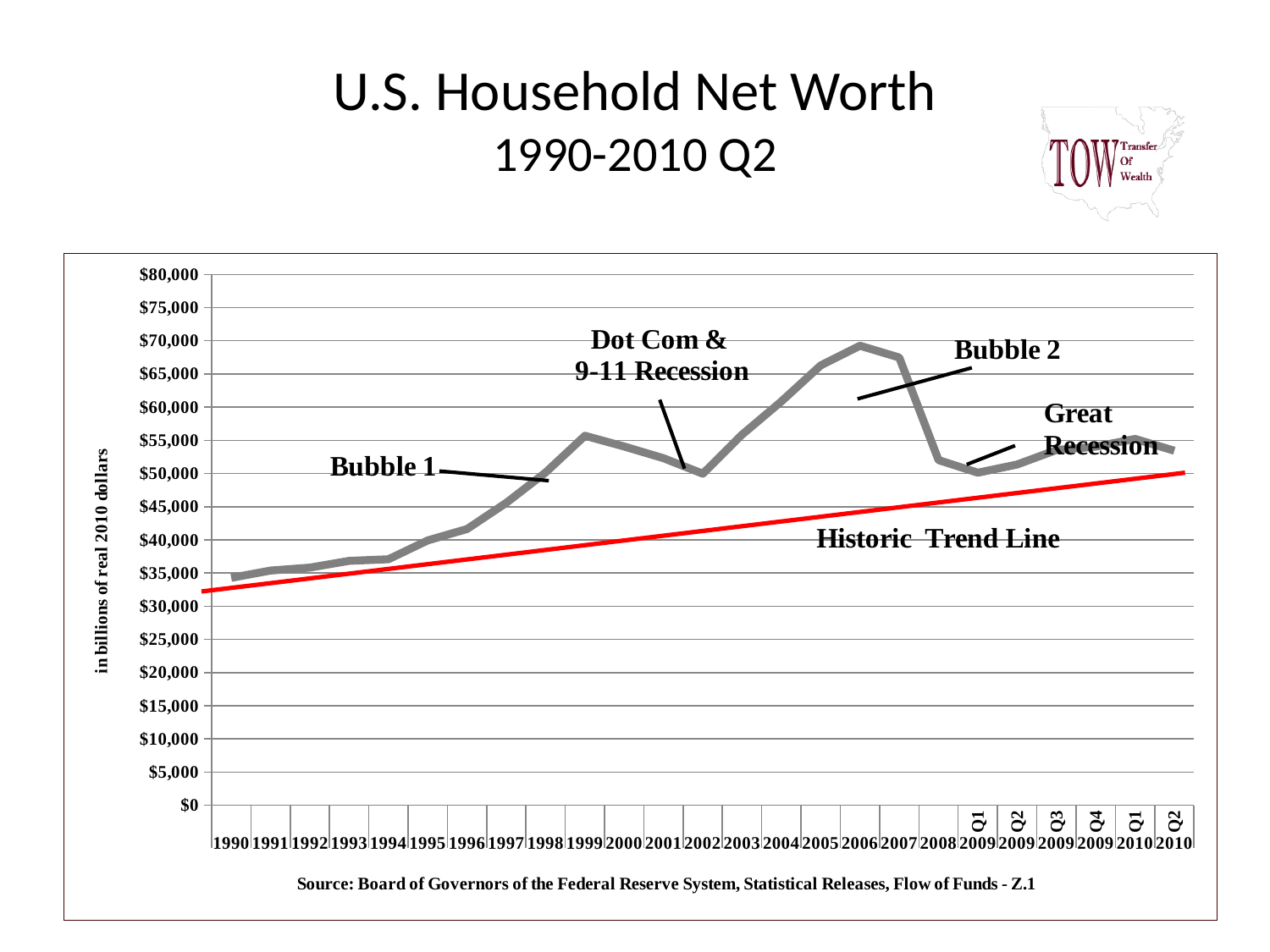
How many points are labelled along the x axis? 25 Which year has the highest household net worth on the chart? 2006 Does household net worth rise or fall from 1990 to 1999? rise What is the label on the y axis? in billions of real 2010 dollars Which is larger, the value for 2006 or the value for 1999? 2006 Is the value for 2006 greater or less than $65,000? greater Which is larger, the value for 1990 or the value for Q2 2010? Q2 2010 Which point on the x axis has the lowest household net worth? 1990 What kind of chart is shown on the slide? line chart Is the value for 2001 greater or less than $50,000? greater